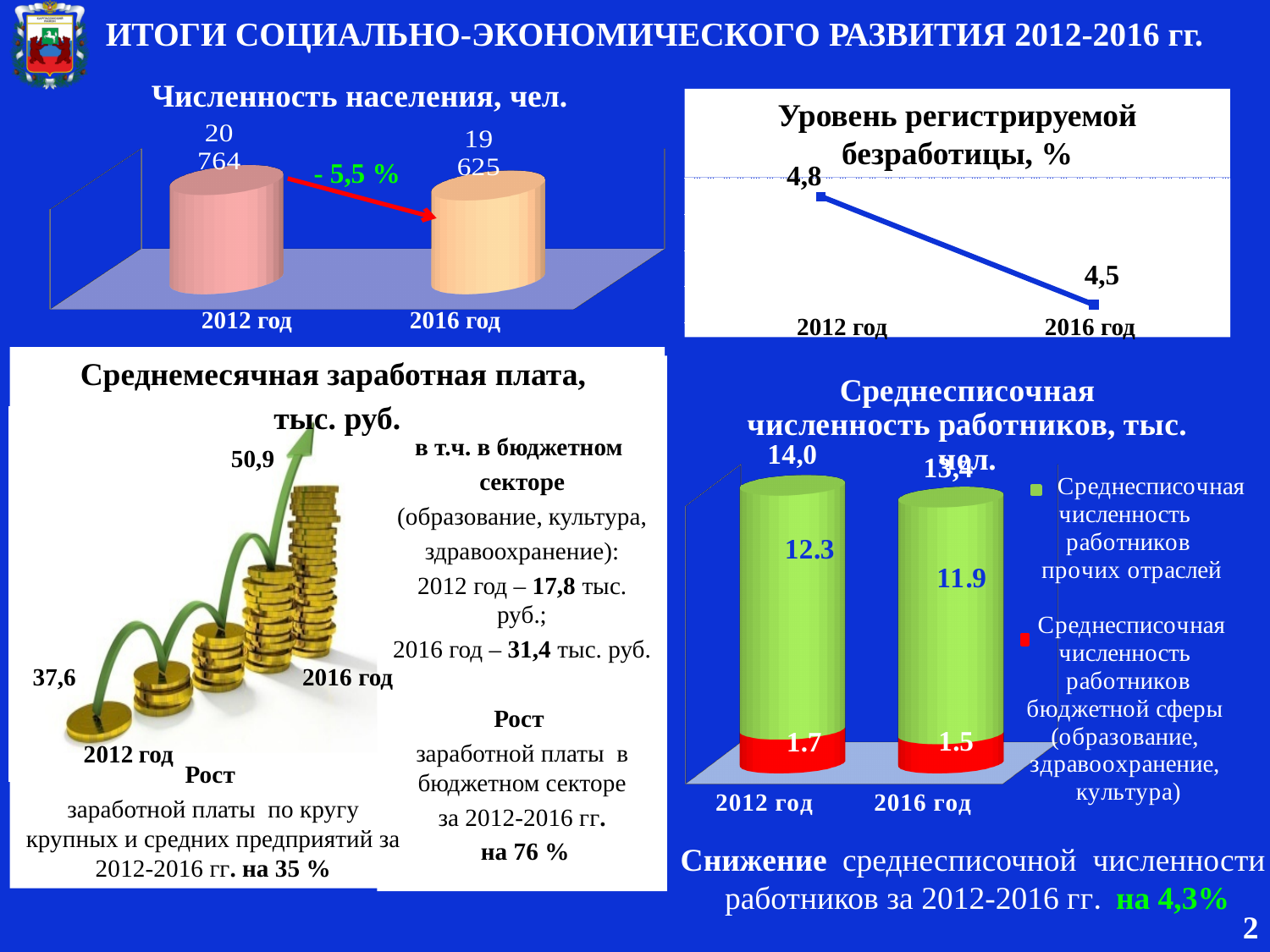
In the chart 'Среднесписочная численность работников, тыс. чел.', what is the total of the stacked bar for 2012 год? 14,0 In the chart 'Среднесписочная численность работников, тыс. чел.', what is the value for workers of other industries (прочих отраслей) in 2016 год? 11.9 In the chart 'Уровень регистрируемой безработицы, %', what is the value for 2016 год? 4,5 What kind of chart is 'Уровень регистрируемой безработицы, %'? line chart In the chart 'Среднемесячная заработная плата, тыс. руб.', which year has the lower value? 2012 год How many series does the legend of the chart 'Среднесписочная численность работников, тыс. чел.' list? 2 In the chart 'Численность населения, чел.', what is the value for 2012 год? 20 764 In the chart 'Численность населения, чел.', what percentage change is shown between 2012 and 2016? - 5,5 % In the chart 'Среднемесячная заработная плата, тыс. руб.', what is the value for 2016 год? 50,9 In the chart 'Уровень регистрируемой безработицы, %', what is the value for 2012 год? 4,8 In the chart 'Уровень регистрируемой безработицы, %', do the values rise or fall from 2012 to 2016? fall In the chart 'Численность населения, чел.', what is the value for 2016 год? 19 625